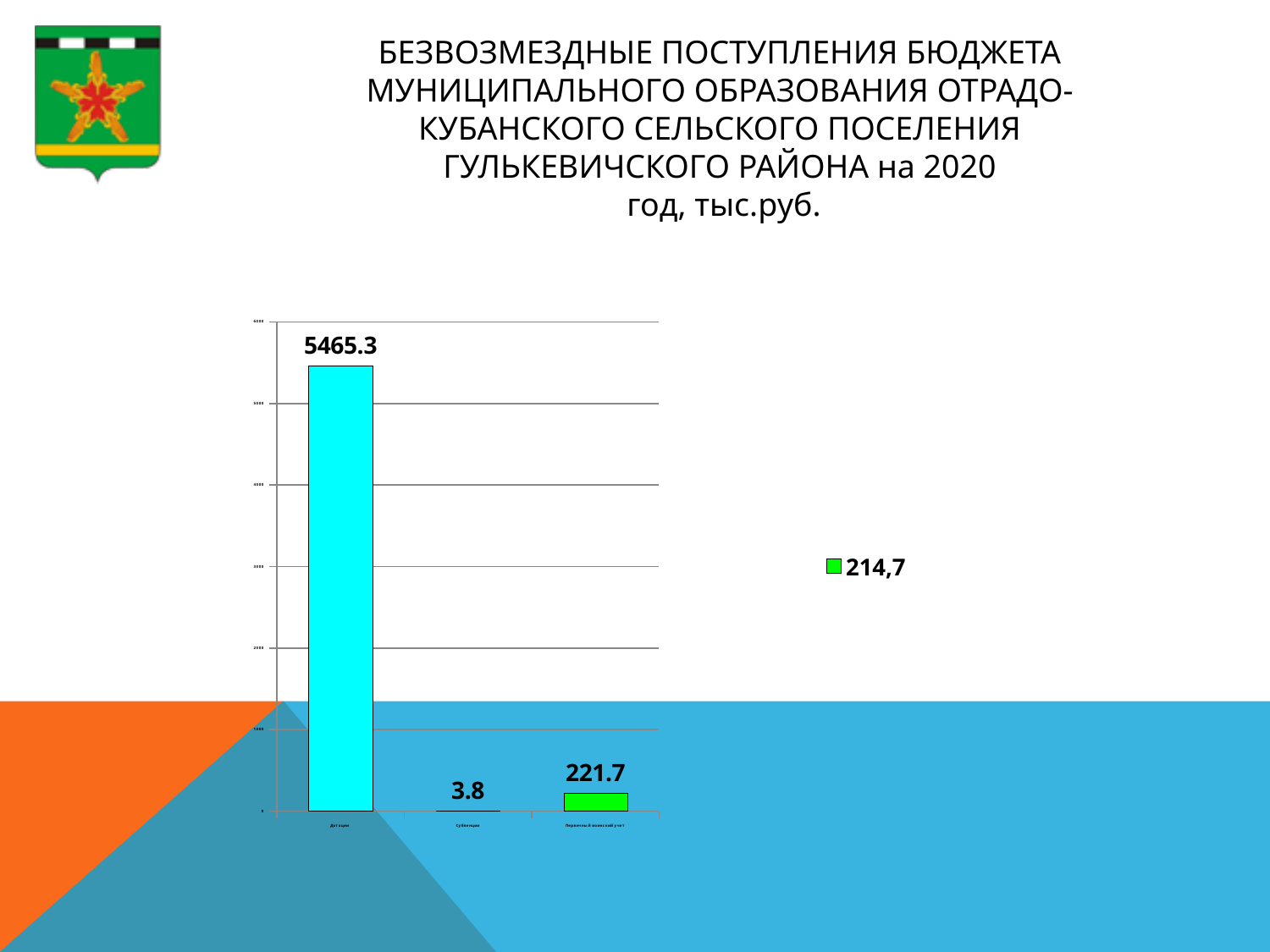
Which is larger, the value of the third bar or the value of the middle bar? the third bar (221.7) What is the value shown on the middle bar? 3.8 Is the value of the first bar greater or less than 5000? greater What is the value shown on the third (rightmost) bar? 221.7 What is the value shown on the first (leftmost) bar? 5465.3 How many bars are plotted in the chart? 3 Which bar has the lowest value? the middle bar, 3.8 What type of chart is shown on the slide? bar chart Which bar has the highest value? the first (leftmost) bar, 5465.3 What text appears in the chart legend? 214,7 What is the difference between the third bar (221.7) and the middle bar (3.8)? 217.9 What is the difference between the first bar (5465.3) and the third bar (221.7)? 5243.6